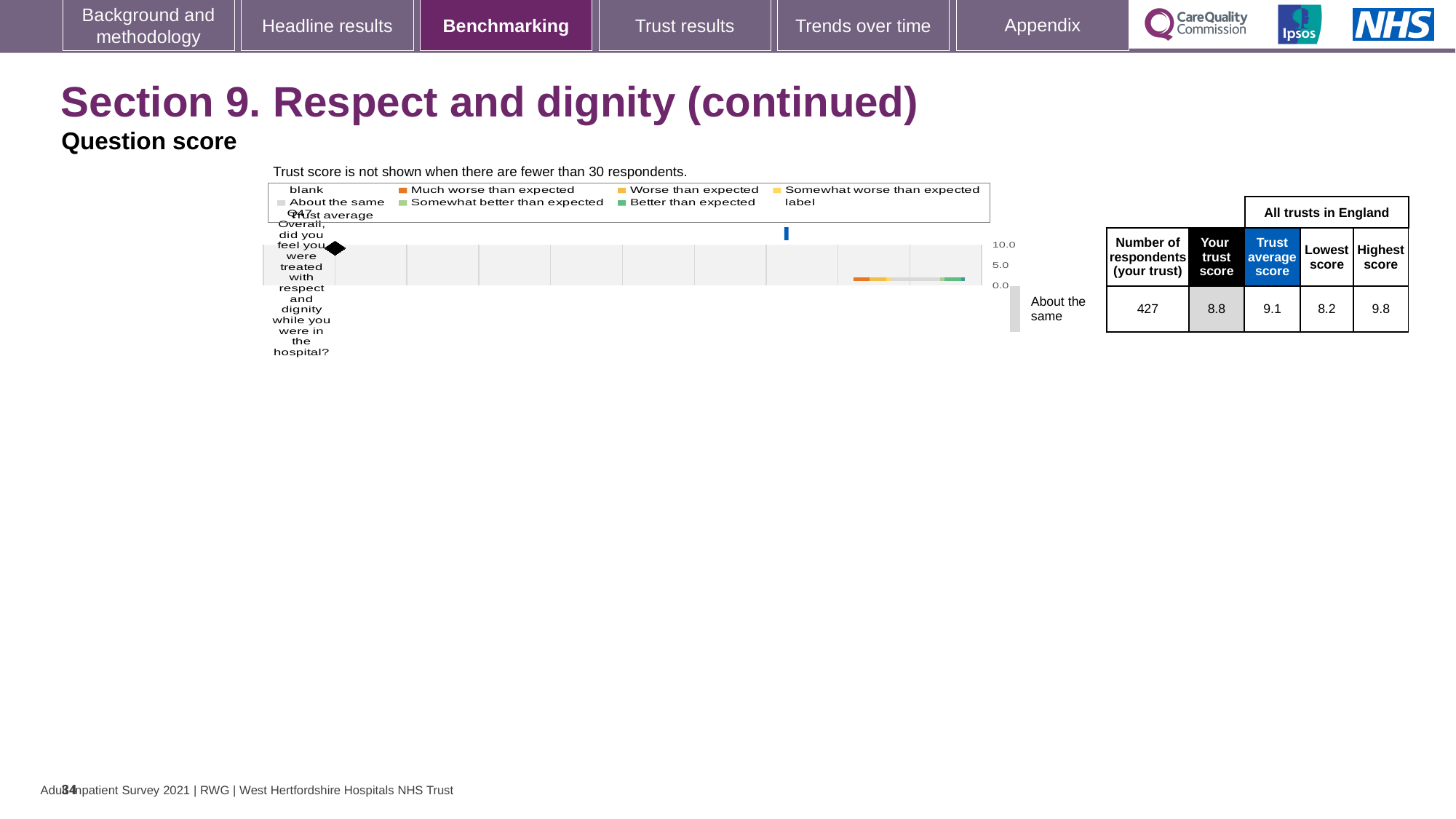
What is the difference between the trust average score and the trust score for Q47? 0.3 What is the lowest score among all trusts in England for Q47? 8.2 Which is larger for Q47: the trust score or the trust average score? Trust average score What kind of chart is used to show the Q47 benchmarking result? Bar chart What is the trust average score for Q47 across all trusts in England? 9.1 What is the maximum value shown on the chart's score axis? 10.0 What is the highest score among all trusts in England for Q47? 9.8 What is the trust score for Q47 shown in the table? 8.8 Is the trust score for Q47 greater or less than 5.0 on the chart axis? greater What is the difference between the highest score and the lowest score for Q47? 1.6 How many respondents from the trust answered Q47? 427 How is the trust's Q47 result categorised relative to expectations? About the same